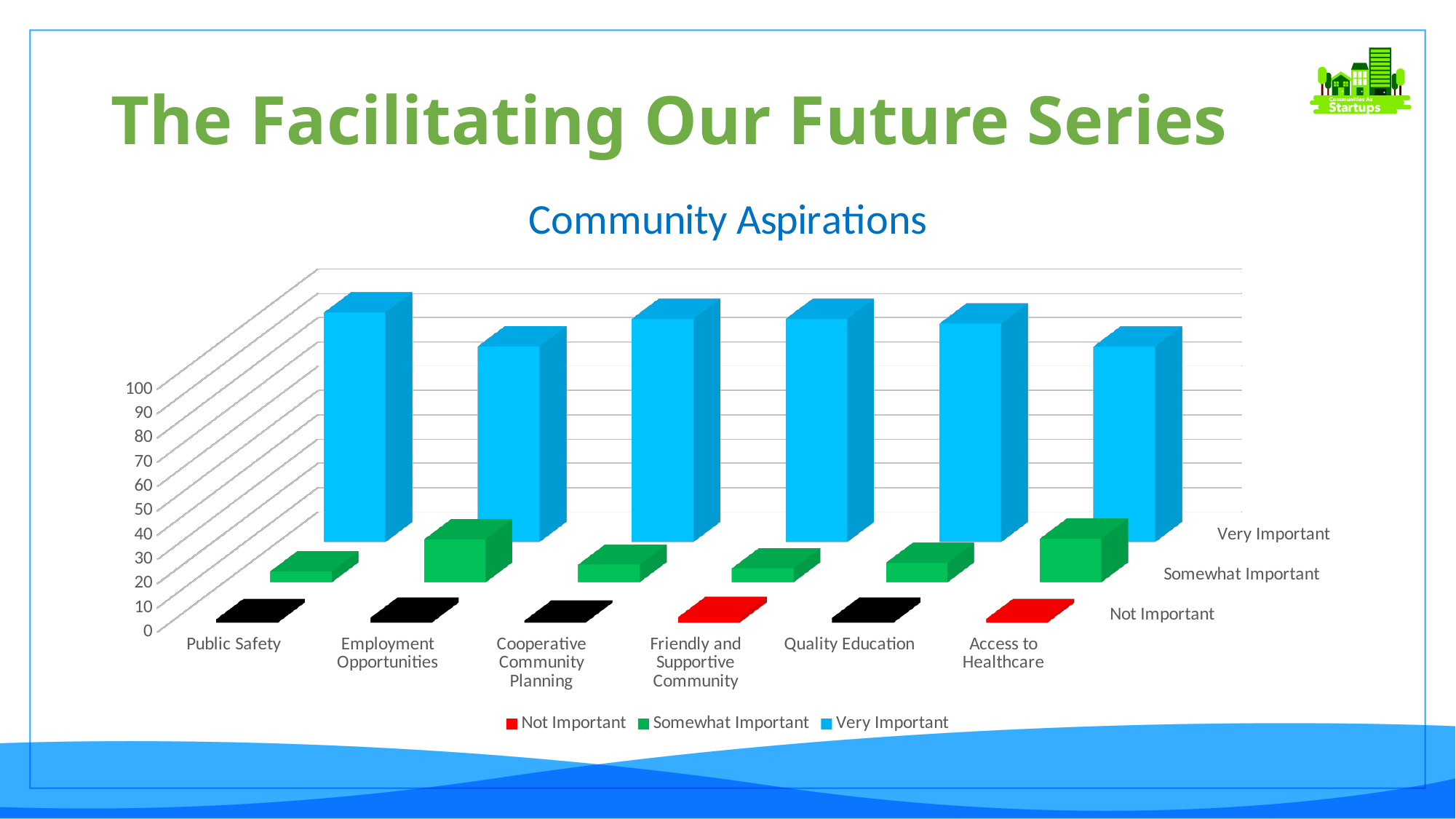
For Public Safety, which is larger: the Very Important value or the Somewhat Important value? Very Important Is the Not Important value for Friendly and Supportive Community greater or less than 10? less For Somewhat Important, which is larger: Employment Opportunities or Public Safety? Employment Opportunities Is the Somewhat Important value for Public Safety greater or less than 30? less What kind of chart is shown on the slide? bar chart For Access to Healthcare, which is larger: the Somewhat Important value or the Not Important value? Somewhat Important What is the title of the chart? Community Aspirations Which series is shown in blue according to the legend? Very Important Is the Very Important value for Public Safety greater or less than 50? greater How many categories are shown on the x axis? 6 How many series does the legend list? 3